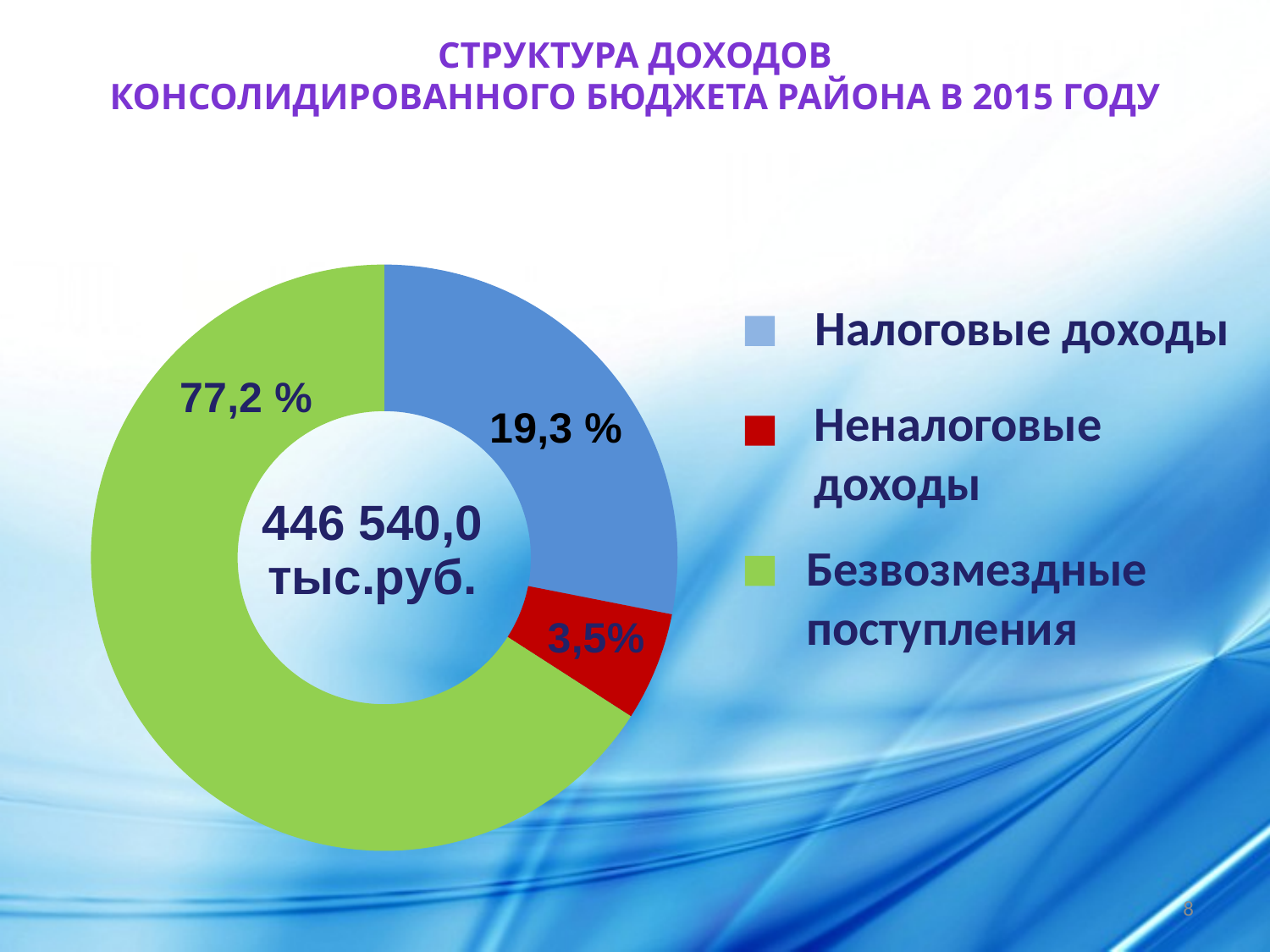
What share of the chart does Налоговые доходы account for? 19,3 % What is the difference in percentage points between Безвозмездные поступления and Налоговые доходы? 57,9 What kind of chart is shown on the slide? Pie (donut) chart How many categories are shown in the chart? 3 What share of the chart does Безвозмездные поступления account for? 77,2 % What is the combined share of Налоговые доходы and Неналоговые доходы? 22,8 % Which category has the largest share of the chart? Безвозмездные поступления Which is larger: the share of Налоговые доходы or the share of Неналоговые доходы? Налоговые доходы What colour represents Неналоговые доходы in the chart? Red What total amount is printed in the centre of the chart? 446 540,0 тыс.руб. What share of the chart does Неналоговые доходы account for? 3,5% Which category has the smallest share of the chart? Неналоговые доходы